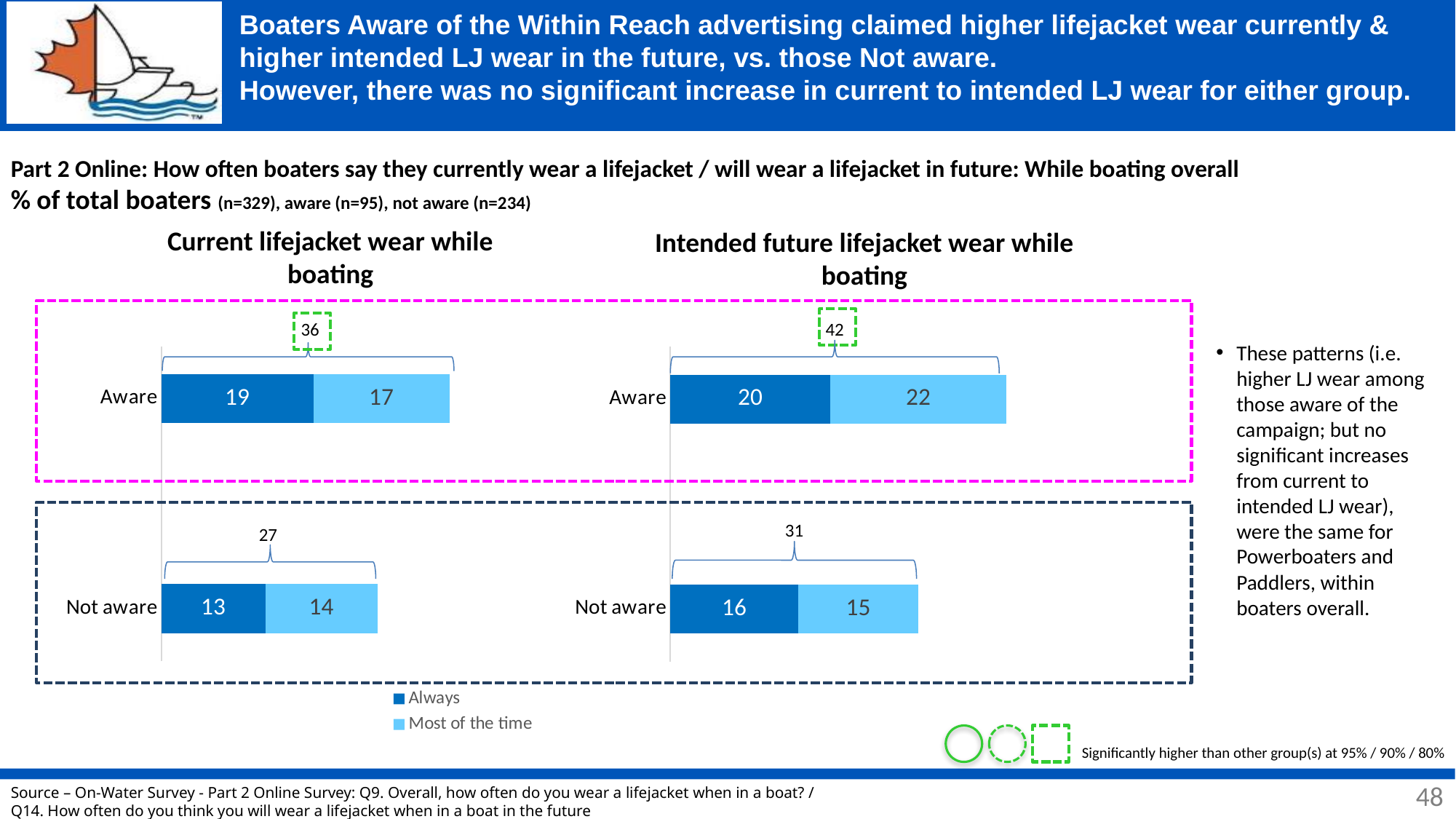
How many series does the legend list for the charts? 2 In the 'Current lifejacket wear while boating' chart, what is the total of the stacked bar for Aware boaters? 36 How many categories are shown in the 'Current lifejacket wear while boating' chart? 2 In the 'Current lifejacket wear while boating' chart, what is the 'Always' value for Aware boaters? 19 In the 'Intended future lifejacket wear while boating' chart, what is the 'Always' value for Not aware boaters? 16 In the 'Current lifejacket wear while boating' chart, what is the 'Most of the time' value for Not aware boaters? 14 In the 'Current lifejacket wear while boating' chart, which group has the lower 'Always' value? Not aware In the 'Current lifejacket wear while boating' chart, what is the difference between the 'Always' values for Aware and Not aware boaters? 6 In the 'Intended future lifejacket wear while boating' chart, what is the 'Most of the time' value for Aware boaters? 22 In the 'Intended future lifejacket wear while boating' chart, what is the total of the stacked bar for Not aware boaters? 31 What type of chart is the 'Intended future lifejacket wear while boating' chart? Stacked bar chart In the 'Intended future lifejacket wear while boating' chart, which group has the higher stacked bar total, Aware or Not aware? Aware